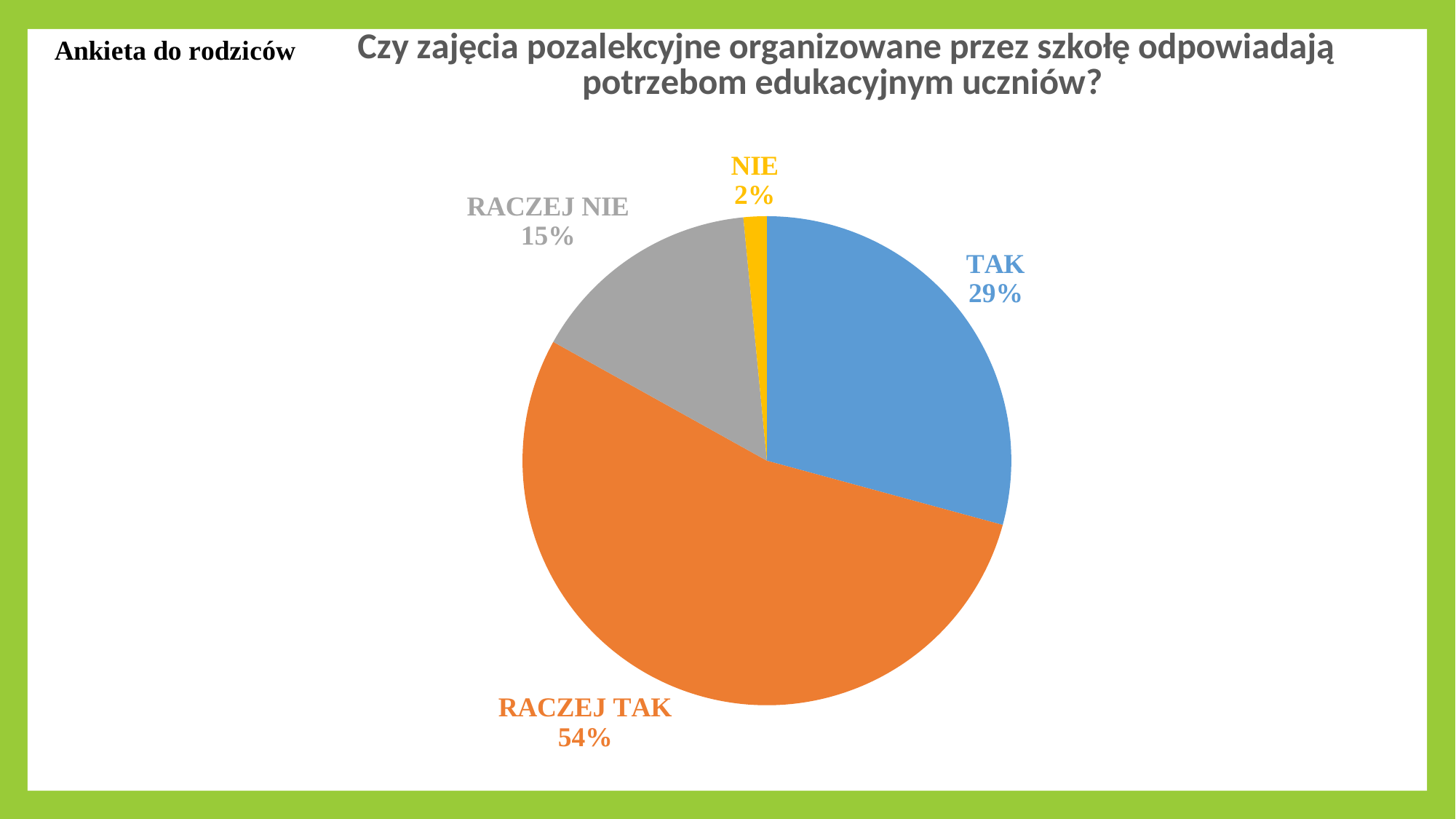
Which category has the largest slice? RACZEJ TAK What colour is the RACZEJ TAK slice? orange What kind of chart is shown on the slide? pie chart How many categories does the pie chart have? 4 What is the value for RACZEJ NIE? 15% Which is larger, TAK or RACZEJ NIE? TAK What share of the pie does RACZEJ TAK have? 54% What is the difference between the values for RACZEJ TAK and TAK? 25% What is the value for NIE? 2% What is the difference between the values for RACZEJ NIE and NIE? 13% Which category has the smallest slice? NIE What is the value for TAK? 29%